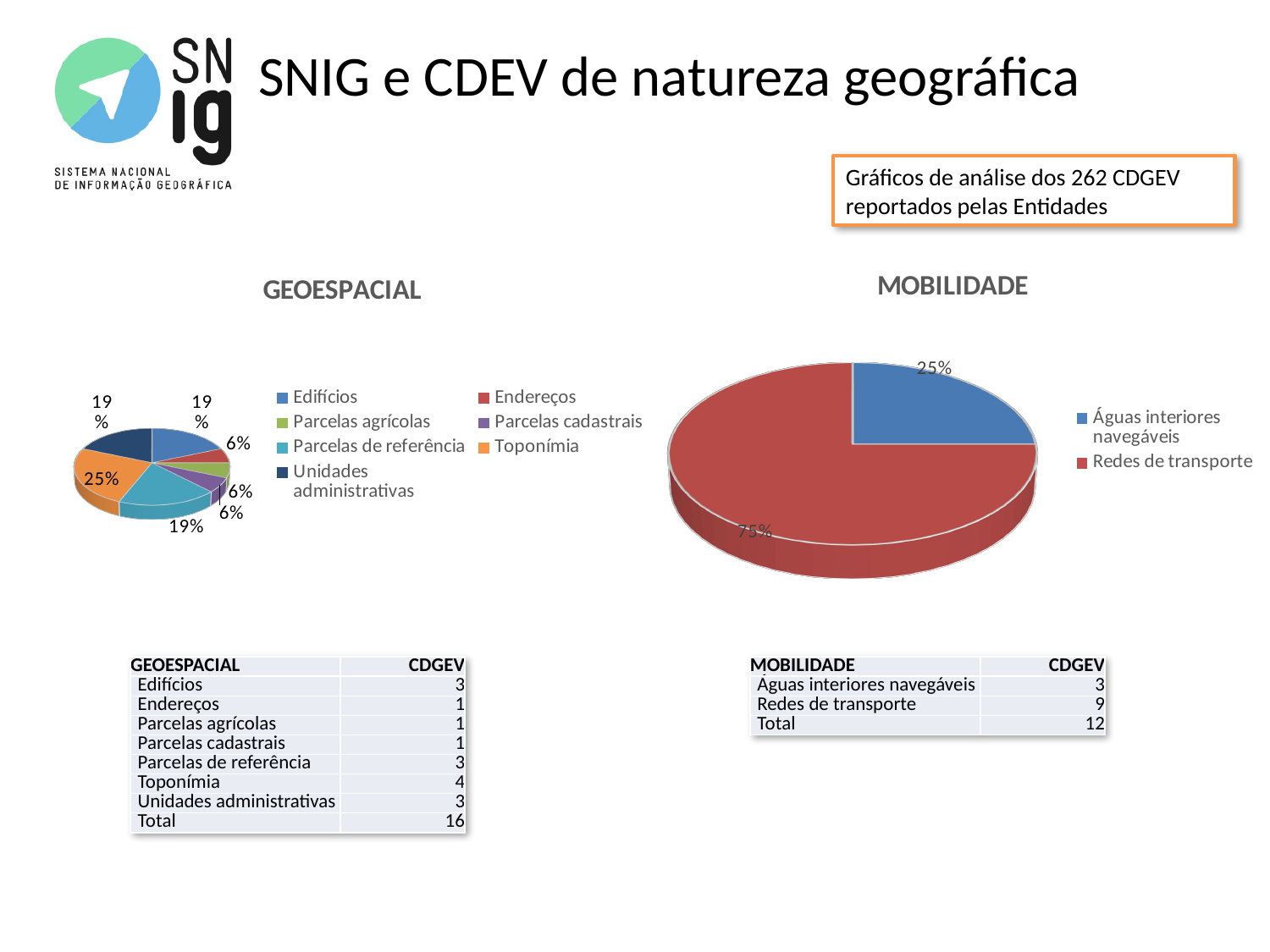
In the GEOESPACIAL chart, which category has the largest slice? Toponímia In the MOBILIDADE chart, what share of the pie is Redes de transporte? 75% In the MOBILIDADE chart, what colour is the Redes de transporte slice? red What kind of chart is the GEOESPACIAL chart? pie chart In the GEOESPACIAL chart, how many categories does the legend list? 7 In the MOBILIDADE chart, what share of the pie is Águas interiores navegáveis? 25% In the GEOESPACIAL chart, what share of the pie is Toponímia? 25% What kind of chart is the MOBILIDADE chart? pie chart In the MOBILIDADE chart, how many categories does the legend list? 2 In the MOBILIDADE chart, what is the difference in percentage points between Redes de transporte and Águas interiores navegáveis? 50 In the GEOESPACIAL chart, which is larger, the slice for Toponímia or the slice for Endereços? Toponímia In the MOBILIDADE chart, which category has the largest slice? Redes de transporte